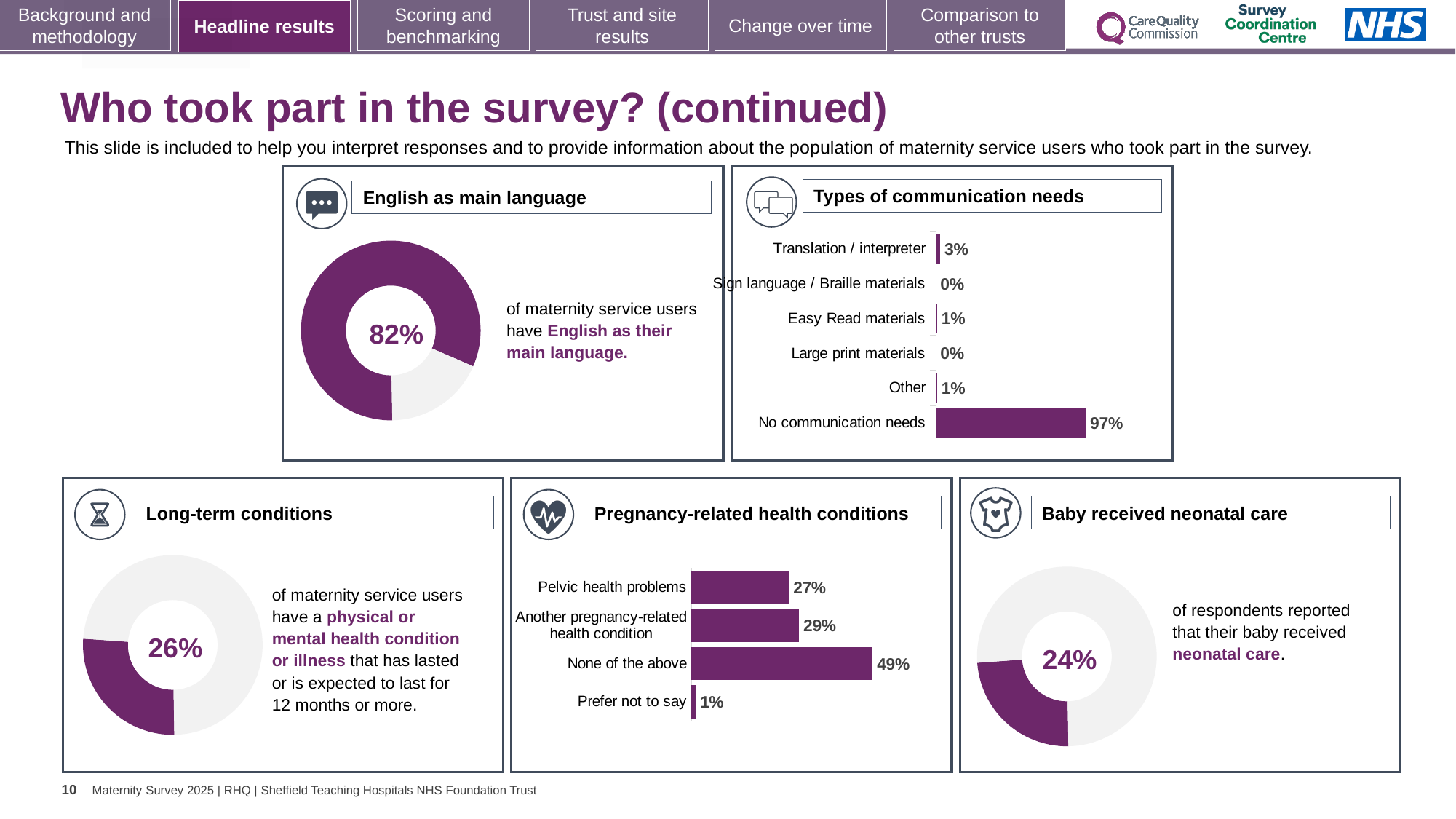
In the 'Pregnancy-related health conditions' chart, what is the value for 'Pelvic health problems'? 27% How many categories are shown in the 'Types of communication needs' chart? 6 In the 'Pregnancy-related health conditions' chart, which category has the lowest value? Prefer not to say In the 'Long-term conditions' chart, what percentage of maternity service users have a physical or mental health condition or illness? 26% In the 'Types of communication needs' chart, what is the value for 'No communication needs'? 97% In the 'Pregnancy-related health conditions' chart, what is the difference between 'Another pregnancy-related health condition' and 'Pelvic health problems'? 2% In the 'Types of communication needs' chart, which category has the highest value? No communication needs In the 'English as main language' chart, what percentage of maternity service users have English as their main language? 82% In the 'Baby received neonatal care' chart, what percentage of respondents reported that their baby received neonatal care? 24% In the 'Pregnancy-related health conditions' chart, which category has the highest value? None of the above In the 'Types of communication needs' chart, what is the value for 'Translation / interpreter'? 3% What type of chart is the 'Types of communication needs' chart? Bar chart